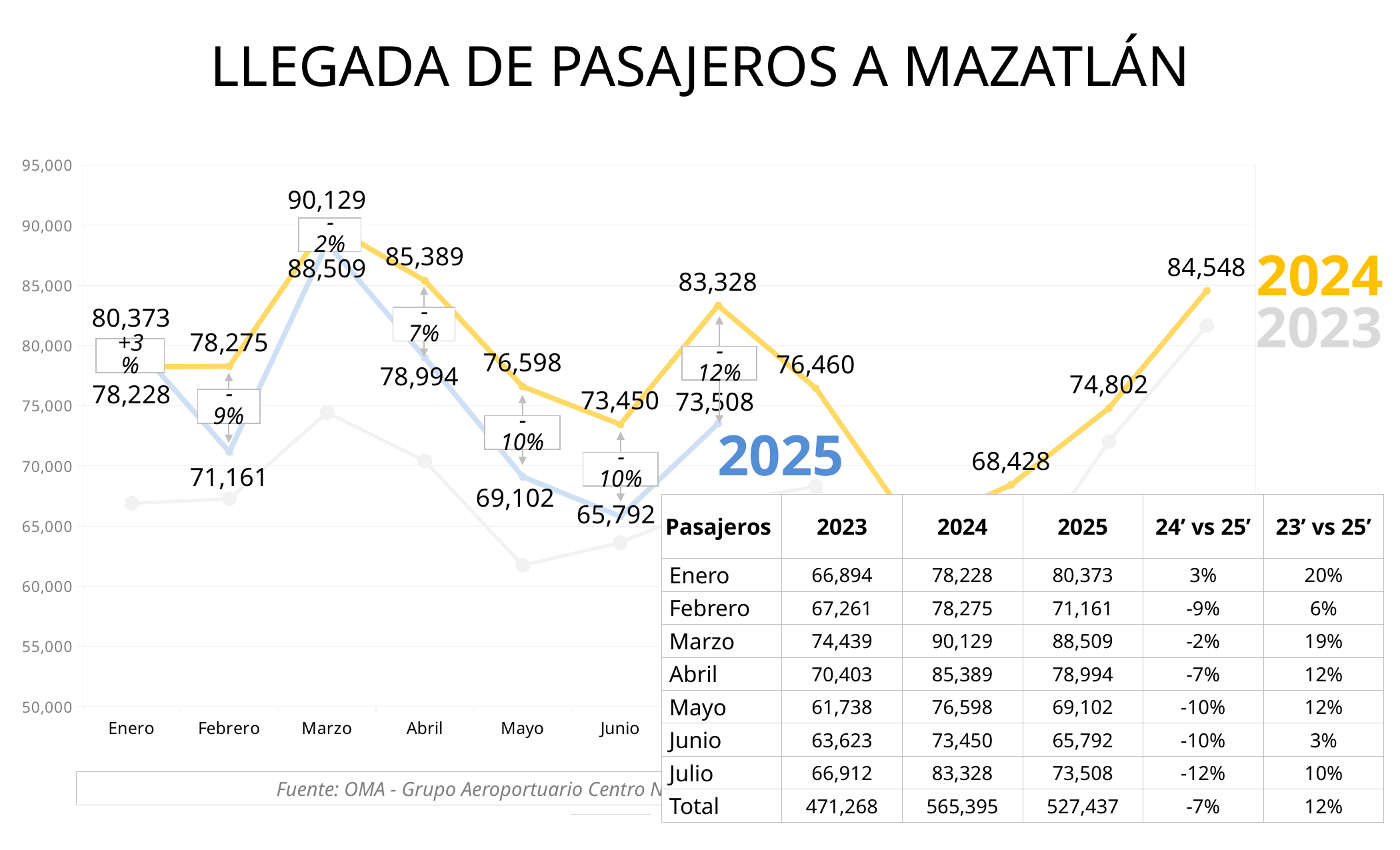
What colour is the 2024 line? yellow Is the 2023 value for Enero greater or less than 70,000? less Which month has the highest 2024 value? Marzo What is the difference between the 2024 and 2025 values for Marzo? 1,620 For Enero, which is larger: the 2024 value or the 2025 value? 2025 What is the percentage change shown for Julio, 24' vs 25'? -12% How many series (years) are plotted on the chart? 3 What kind of chart is shown? line chart Which month has the lowest 2025 value? Junio What is the 2025 value for Febrero? 71,161 What is the 2024 value for Marzo? 90,129 Do the 2025 values rise or fall from Marzo to Junio? fall